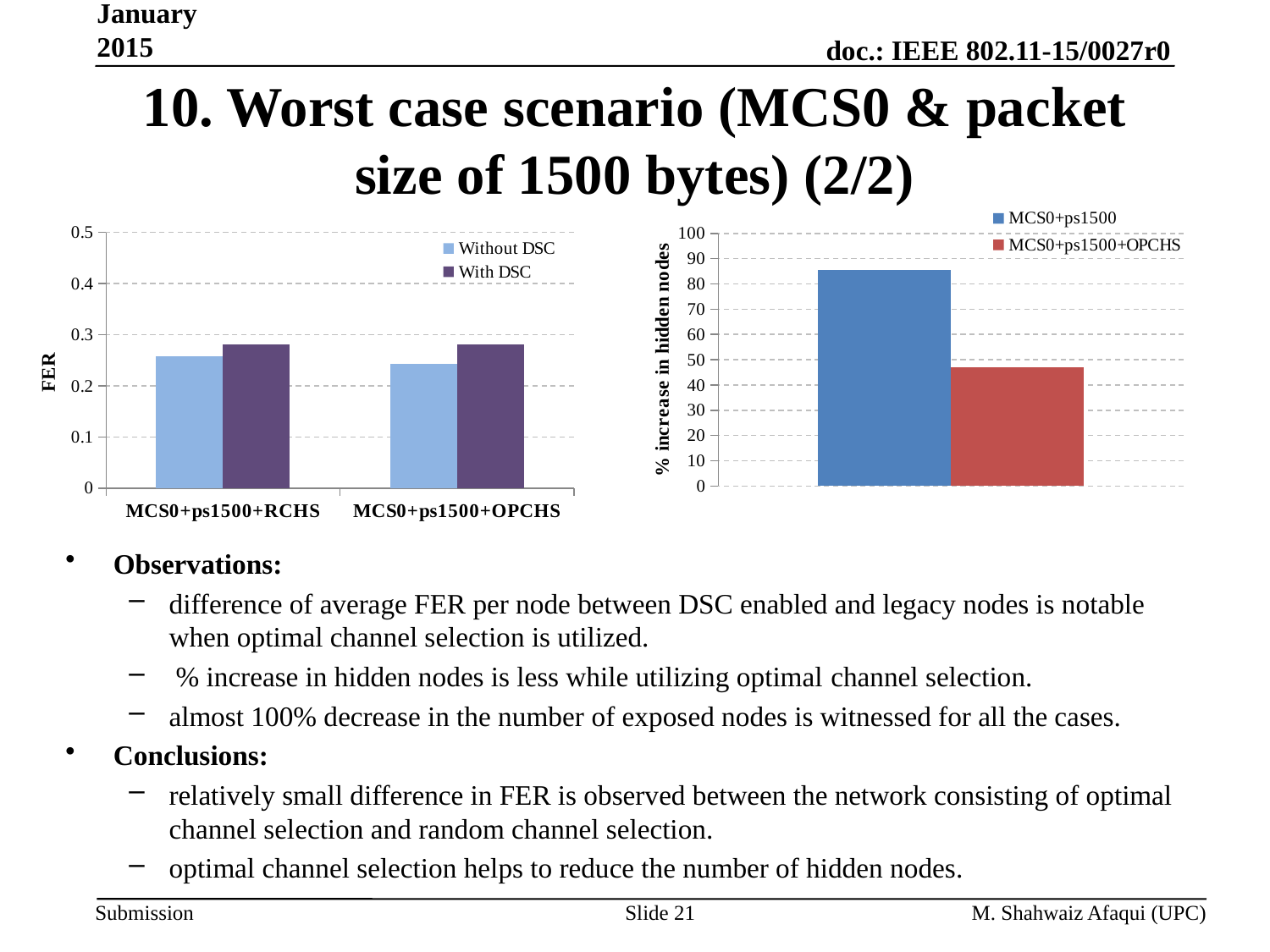
In the right chart (% increase in hidden nodes), is the value for MCS0+ps1500 greater or less than 80? greater In the right chart (% increase in hidden nodes), how many series does the legend list? 2 In the left chart (FER), how many categories are shown on the x axis? 2 In the left chart (FER), for MCS0+ps1500+OPCHS, which is larger: Without DSC or With DSC? With DSC In the left chart (FER), is the Without DSC value for MCS0+ps1500+RCHS greater or less than 0.2? greater In the left chart (FER), is the Without DSC value for MCS0+ps1500+OPCHS greater or less than 0.3? less What kind of chart is the right chart (% increase in hidden nodes)? bar chart What is the y-axis label of the left chart? FER In the right chart (% increase in hidden nodes), which series has the higher value: MCS0+ps1500 or MCS0+ps1500+OPCHS? MCS0+ps1500 What kind of chart is the left chart (FER)? bar chart In the left chart (FER), how many series does the legend list? 2